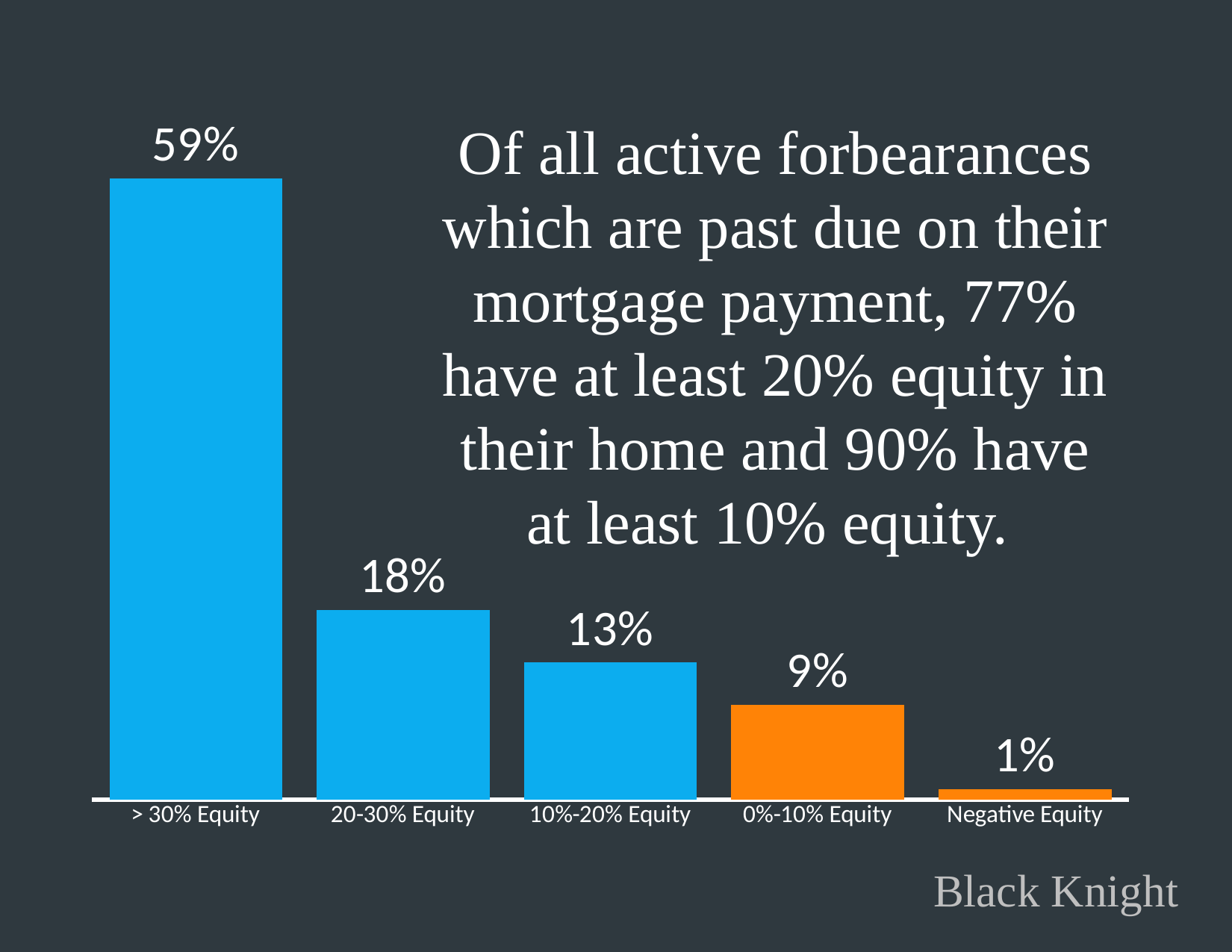
Which category has the lowest value? Negative Equity Do the values rise or fall moving from left to right along the x axis? Fall What is the value for 0%-10% Equity? 9% What is the value for 10%-20% Equity? 13% What kind of chart is shown on the slide? Bar chart What is the difference between the values for > 30% Equity and 20-30% Equity? 41% Which is larger, the value for 10%-20% Equity or the value for 0%-10% Equity? 10%-20% Equity How many categories are shown in the chart? 5 What is the value for Negative Equity? 1% What is the value for > 30% Equity? 59% What is the value for 20-30% Equity? 18% Which category has the highest value? > 30% Equity